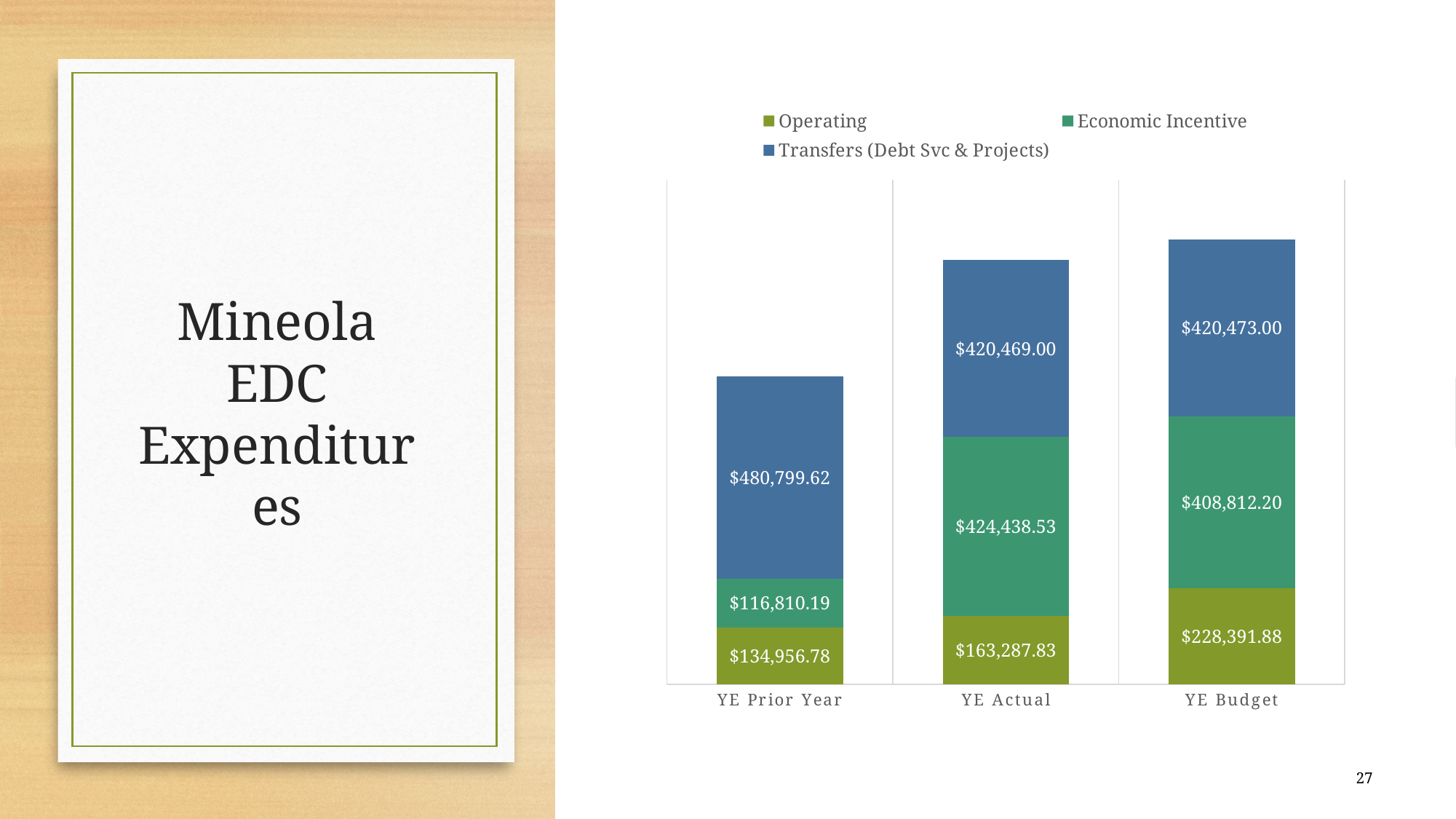
How many categories are shown on the x axis? 3 What is the Operating value for YE Prior Year? $134,956.78 How many series does the legend list? 3 What is the total of the YE Prior Year stacked bar? $732,566.59 What is the Economic Incentive value for YE Actual? $424,438.53 Which category has the highest Operating value? YE Budget What is the difference between the Operating values for YE Budget and YE Prior Year? $93,435.10 Which category has the lowest Economic Incentive value? YE Prior Year Which series is shown in blue in the legend? Transfers (Debt Svc & Projects) What is the Transfers (Debt Svc & Projects) value for YE Budget? $420,473.00 Which category has the highest Transfers (Debt Svc & Projects) value? YE Prior Year What kind of chart is shown on the slide? Stacked bar chart